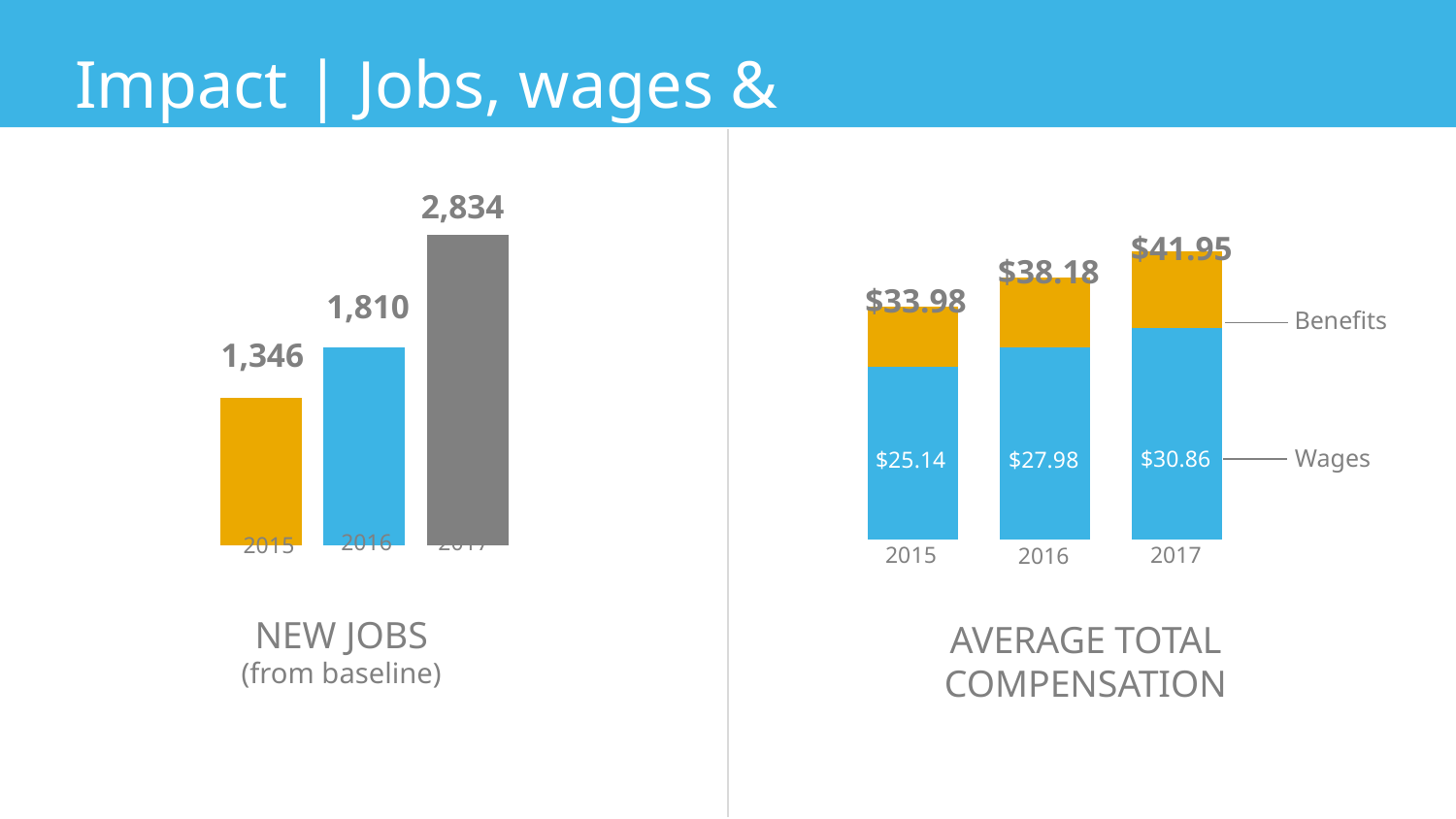
In the AVERAGE TOTAL COMPENSATION chart, which year has the lowest total compensation? 2015 In the NEW JOBS chart, what is the difference between the 2017 and 2016 values? 1,024 In the NEW JOBS chart, which year has the lowest number of new jobs? 2015 In the NEW JOBS chart, how many years are shown? 3 What kind of chart is the AVERAGE TOTAL COMPENSATION chart? stacked bar chart In the NEW JOBS chart, which year has the highest number of new jobs? 2017 In the NEW JOBS chart, how many new jobs were there in 2016? 1,810 In the AVERAGE TOTAL COMPENSATION chart, what is the difference in Wages between 2017 and 2015? $5.72 In the AVERAGE TOTAL COMPENSATION chart, what is the Wages value for 2016? $27.98 In the AVERAGE TOTAL COMPENSATION chart, how many series does the legend list? 2 In the AVERAGE TOTAL COMPENSATION chart, what is the total compensation for 2017? $41.95 In the NEW JOBS chart, do the values rise or fall from 2015 to 2017? rise